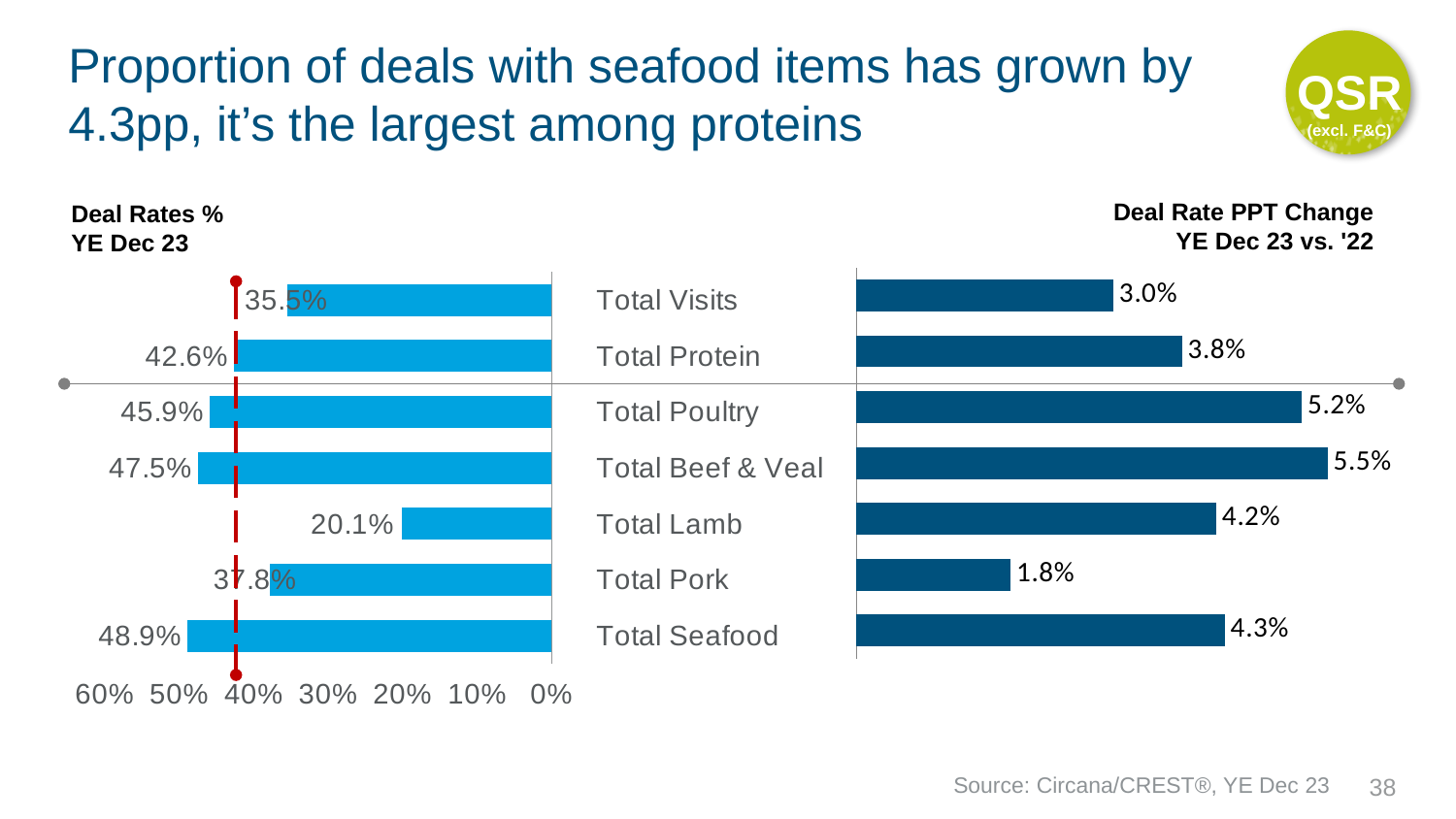
In the Deal Rate PPT Change YE Dec 23 vs. '22 chart, what is the value for Total Pork? 1.8% In the Deal Rate PPT Change YE Dec 23 vs. '22 chart, which category has the largest change? Total Beef & Veal In the Deal Rate PPT Change YE Dec 23 vs. '22 chart, which is larger: the change for Total Poultry or for Total Lamb? Total Poultry In the Deal Rates % YE Dec 23 chart, what is the difference between the deal rates for Total Seafood and Total Visits? 13.4 percentage points In the Deal Rate PPT Change YE Dec 23 vs. '22 chart, what is the value for Total Seafood? 4.3% In the Deal Rates % YE Dec 23 chart, which category has the lowest deal rate? Total Lamb How many categories are shown in the Deal Rates % YE Dec 23 chart? 7 In the Deal Rates % YE Dec 23 chart, what is the deal rate for Total Lamb? 20.1% In the Deal Rates % YE Dec 23 chart, what is the deal rate for Total Seafood? 48.9% In the Deal Rate PPT Change YE Dec 23 vs. '22 chart, which category has the smallest change? Total Pork In the Deal Rates % YE Dec 23 chart, which category has the highest deal rate? Total Seafood What type of chart is the Deal Rate PPT Change YE Dec 23 vs. '22 chart? Bar chart